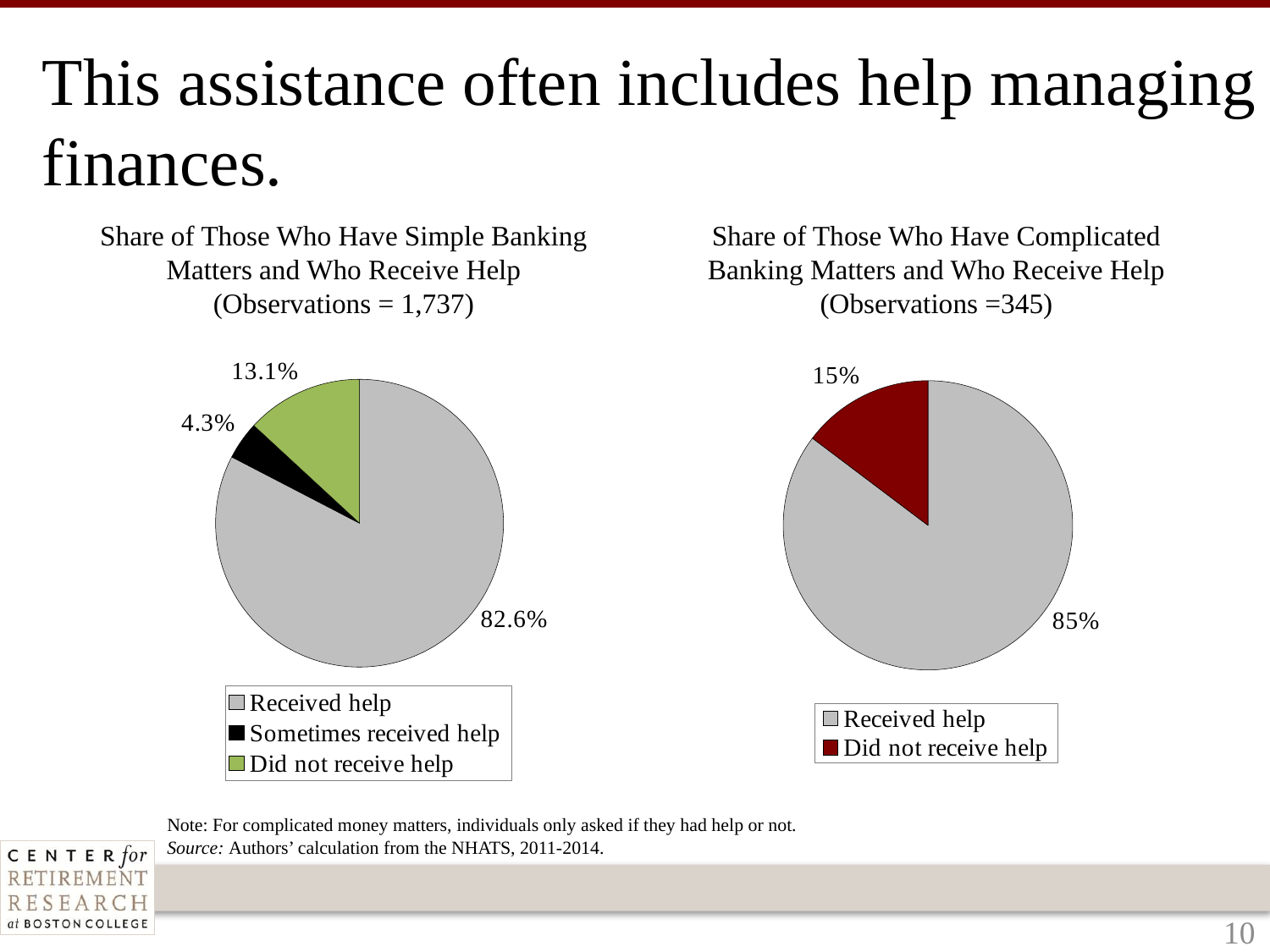
In the right pie chart (Complicated Banking Matters), what is the difference between the share that received help and the share that did not? 70% In the left pie chart (Simple Banking Matters), which category has the largest share? Received help What type of chart is used on the right side of the slide (Complicated Banking Matters)? Pie chart In the left pie chart (Simple Banking Matters), which category has the smallest share? Sometimes received help In the left pie chart (Simple Banking Matters), what share sometimes received help? 4.3% In the left pie chart (Simple Banking Matters), what is the difference between the share that did not receive help and the share that sometimes received help? 8.8% In the left pie chart (Simple Banking Matters), what share received help? 82.6% In the right pie chart (Complicated Banking Matters), what share did not receive help? 15% How many categories does the legend of the right pie chart (Complicated Banking Matters) list? 2 How many categories does the legend of the left pie chart (Simple Banking Matters) list? 3 In the left pie chart (Simple Banking Matters), what share did not receive help? 13.1% In the right pie chart (Complicated Banking Matters), what share received help? 85%